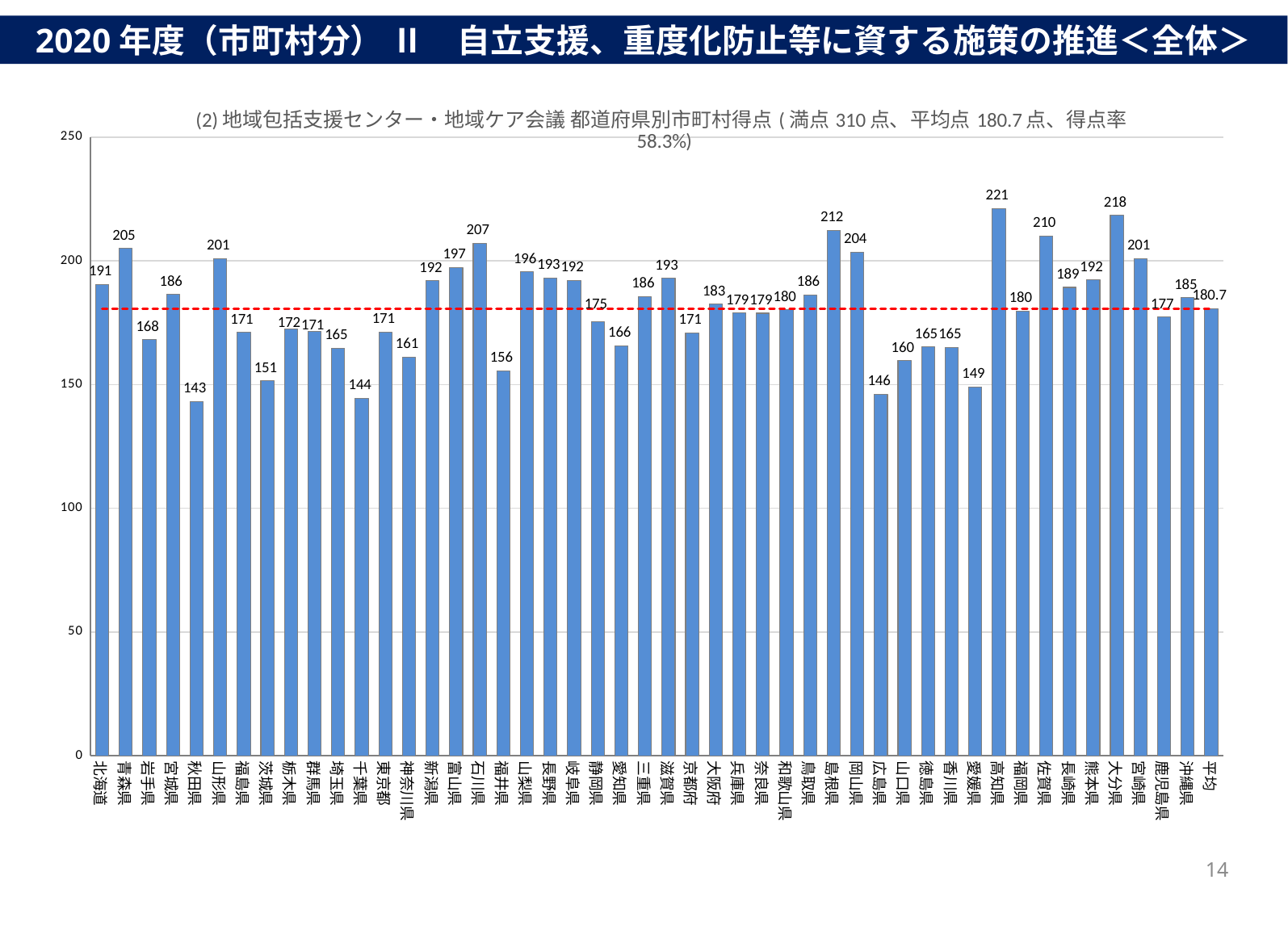
Which prefecture has the lowest value? 秋田県 What is the difference between the values for 大分県 and 広島県? 72 What does the red dashed horizontal line represent? 平均点 180.7点 What kind of chart is shown on the slide? bar chart Which prefecture has the highest value? 高知県 Which has a larger value, 島根県 or 岡山県? 島根県 What is the value for 秋田県? 143 What is the value for 高知県? 221 What is the value for 石川県? 207 Is the value for 愛媛県 greater or less than 150? less How many bars are plotted in the chart, including 平均? 48 What is the value shown for 平均? 180.7